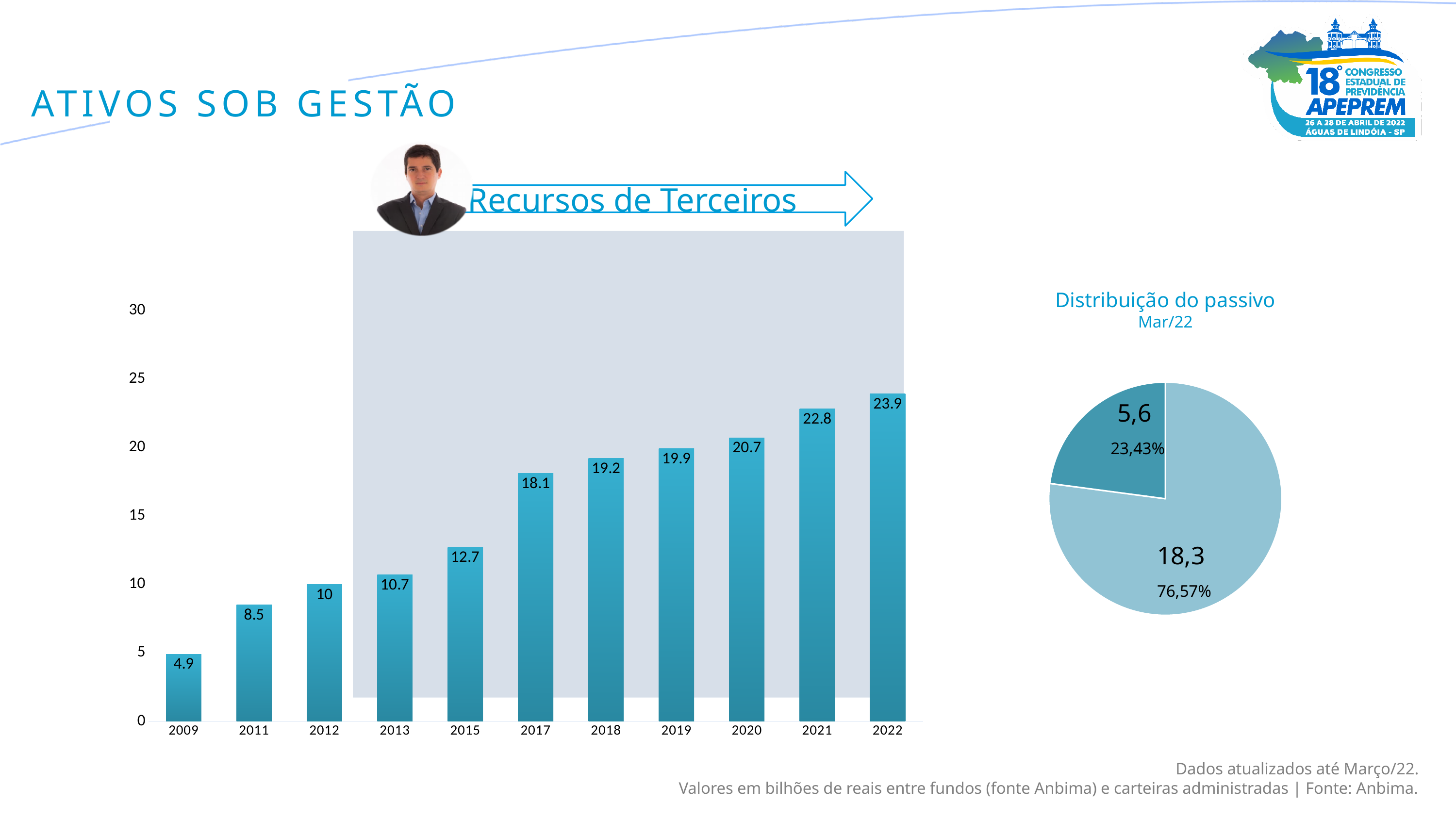
In the bar chart on the left, what is the value for 2009? 4.9 In the bar chart on the left, how many years are shown on the x axis? 11 In the bar chart on the left, which year has the lowest value? 2009 In the bar chart on the left, what is the value for 2022? 23.9 In the bar chart on the left, which is larger, the value for 2013 or the value for 2015? 2015 In the bar chart on the left, what is the value for 2017? 18.1 In the bar chart on the left, what is the difference between the values for 2022 and 2021? 1.1 In the pie chart 'Distribuição do passivo', what share does the slice with value 18,3 have? 76,57% In the pie chart 'Distribuição do passivo', what is the value of the smaller slice? 5,6 In the bar chart on the left, which year has the highest value? 2022 In the bar chart on the left, do the values rise or fall from 2009 to 2022? rise What kind of chart is the chart on the left? bar chart